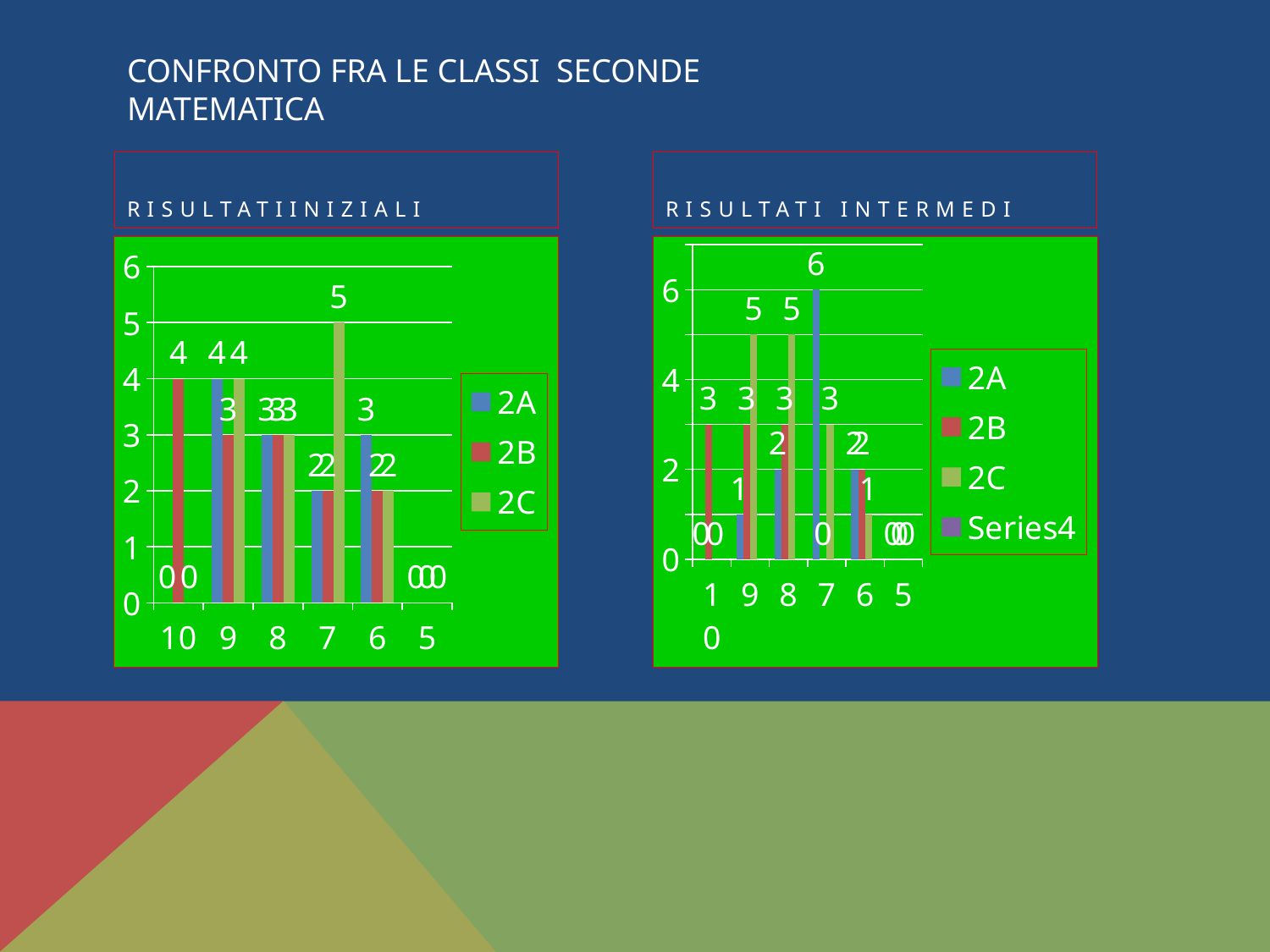
In the RISULTATI INTERMEDI chart, what is the value for 2A at category 7? 6 In the RISULTATI INTERMEDI chart, what is the difference between 2A and 2C at category 7? 3 What type of chart is the RISULTATI INTERMEDI chart? Bar chart In the RISULTATI INIZIALI chart, which series reaches the highest value? 2C In the RISULTATI INIZIALI chart, what is the value for 2C at category 7? 5 In the RISULTATI INIZIALI chart, is the value for 2B larger at category 10 or at category 7? 10 In the RISULTATI INTERMEDI chart, what is the value for 2C at category 9? 5 How many categories are shown on the x axis of the RISULTATI INIZIALI chart? 6 How many series does the legend of the RISULTATI INTERMEDI chart list? 4 In the RISULTATI INIZIALI chart, what is the value for 2B at category 10? 4 In the RISULTATI INTERMEDI chart, which series has the highest single value? 2A How many series does the legend of the RISULTATI INIZIALI chart list? 3